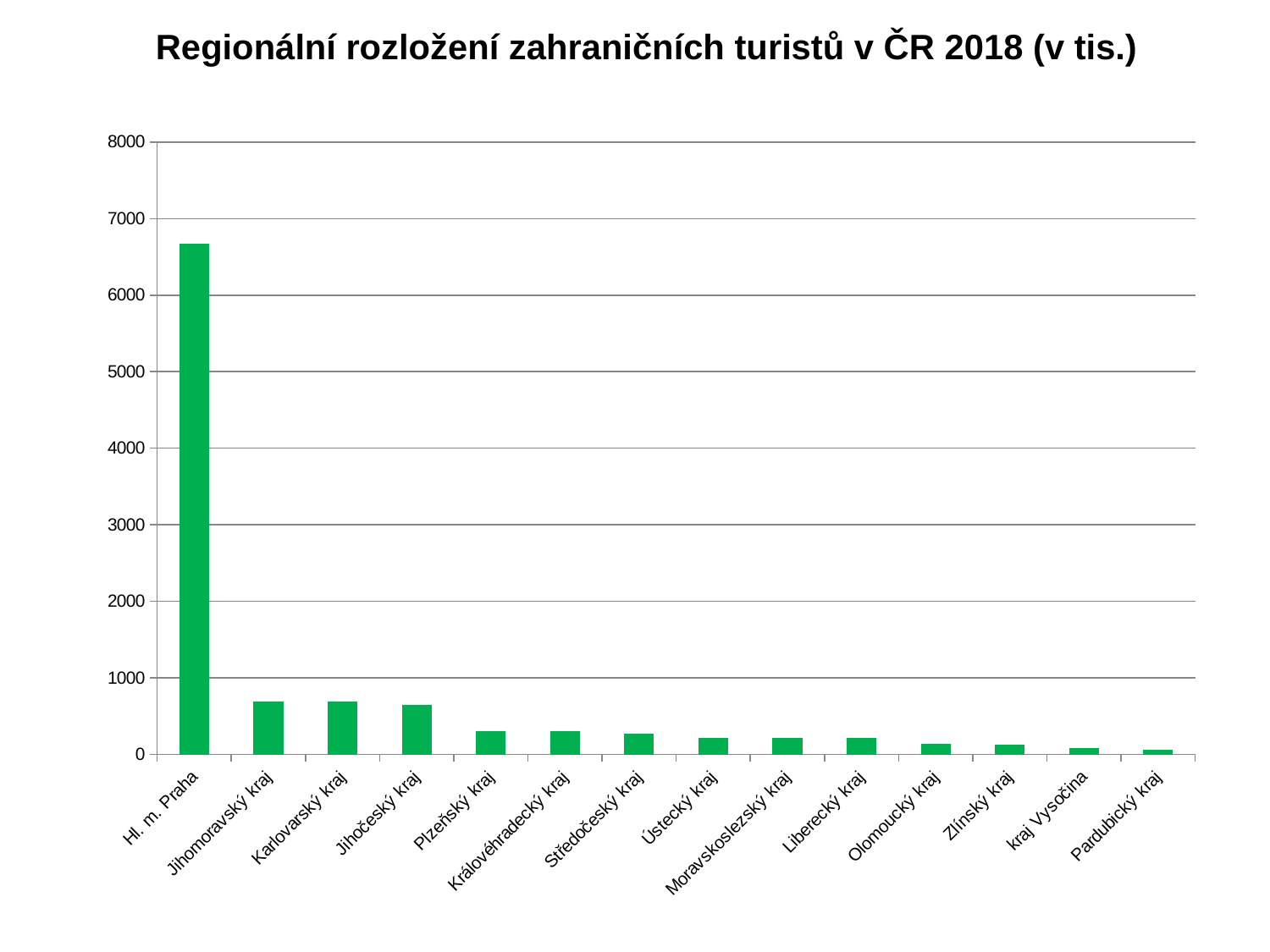
Which region has the highest value? Hl. m. Praha What kind of chart is shown on the slide? bar chart Is the value for Plzeňský kraj greater or less than 1000? less Is the value for Hl. m. Praha greater or less than 7000? less Which is larger, the value for Hl. m. Praha or the value for Jihomoravský kraj? Hl. m. Praha What is the title of the chart? Regionální rozložení zahraničních turistů v ČR 2018 (v tis.) Which region has the lowest value? Pardubický kraj Do the values generally rise or fall from left to right along the x axis? fall Is the value for Jihomoravský kraj greater or less than 1000? less How many regions (categories) are shown on the x axis? 14 Which is larger, the value for Jihočeský kraj or the value for Olomoucký kraj? Jihočeský kraj